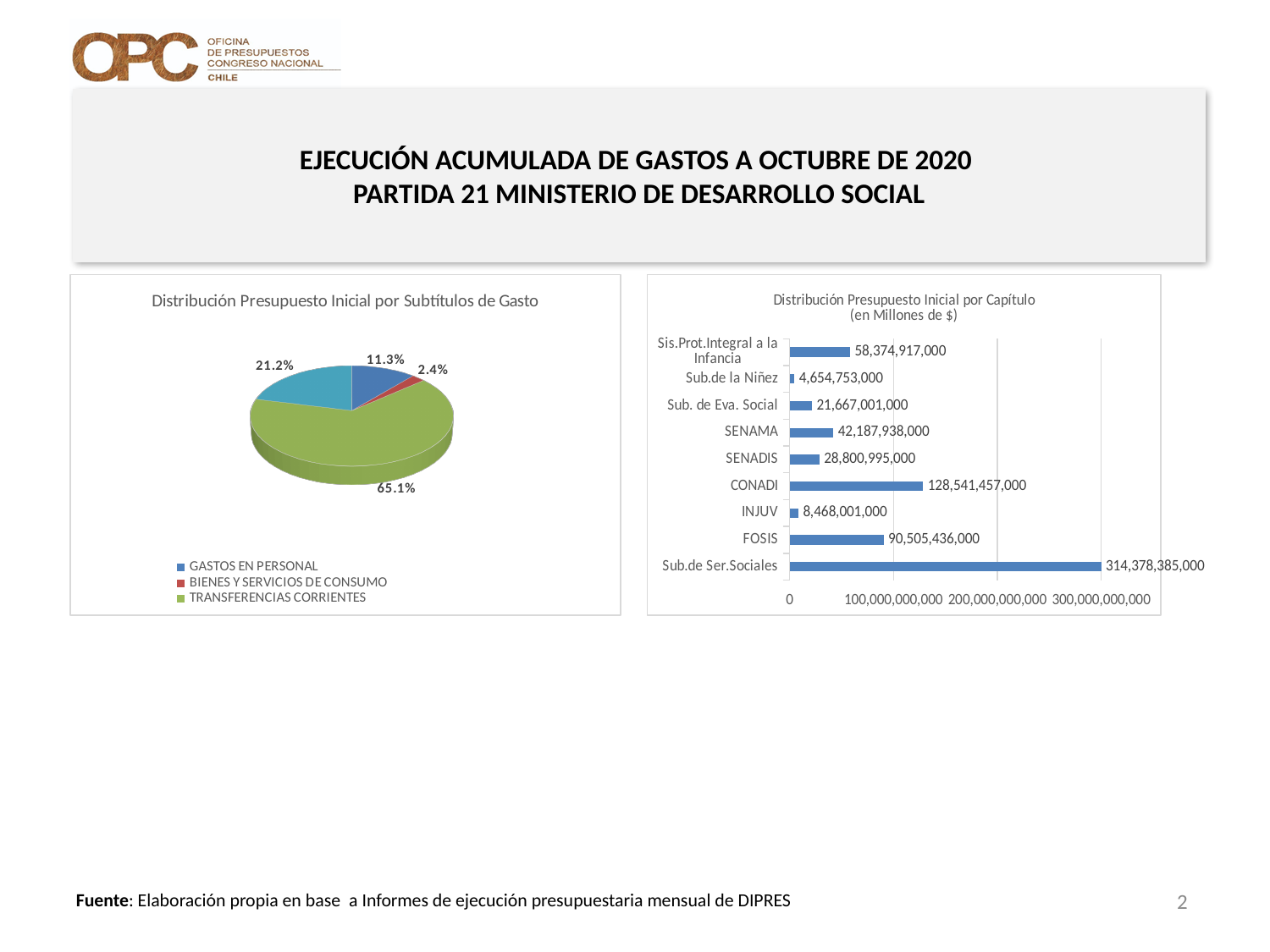
In the 'Distribución Presupuesto Inicial por Subtítulos de Gasto' pie chart, what share does TRANSFERENCIAS CORRIENTES have? 65.1% In the 'Distribución Presupuesto Inicial por Subtítulos de Gasto' pie chart, what share does GASTOS EN PERSONAL have? 11.3% In the 'Distribución Presupuesto Inicial por Capítulo' chart, what is the value for Sub.de la Niñez? 4,654,753,000 In the 'Distribución Presupuesto Inicial por Capítulo' chart, which category has the highest value? Sub.de Ser.Sociales In the 'Distribución Presupuesto Inicial por Capítulo' chart, which category has the lowest value? Sub.de la Niñez In the 'Distribución Presupuesto Inicial por Capítulo' chart, which is larger, FOSIS or Sis.Prot.Integral a la Infancia? FOSIS How many categories are shown in the 'Distribución Presupuesto Inicial por Capítulo' chart? 9 What kind of chart is the 'Distribución Presupuesto Inicial por Subtítulos de Gasto' chart? Pie chart What kind of chart is the 'Distribución Presupuesto Inicial por Capítulo' chart? Bar chart In the 'Distribución Presupuesto Inicial por Capítulo' chart, what is the difference between the values for SENAMA and SENADIS? 13,386,943,000 In the 'Distribución Presupuesto Inicial por Capítulo' chart, is the value for CONADI greater or less than 100,000,000,000? greater In the 'Distribución Presupuesto Inicial por Capítulo' chart, what is the value for CONADI? 128,541,457,000